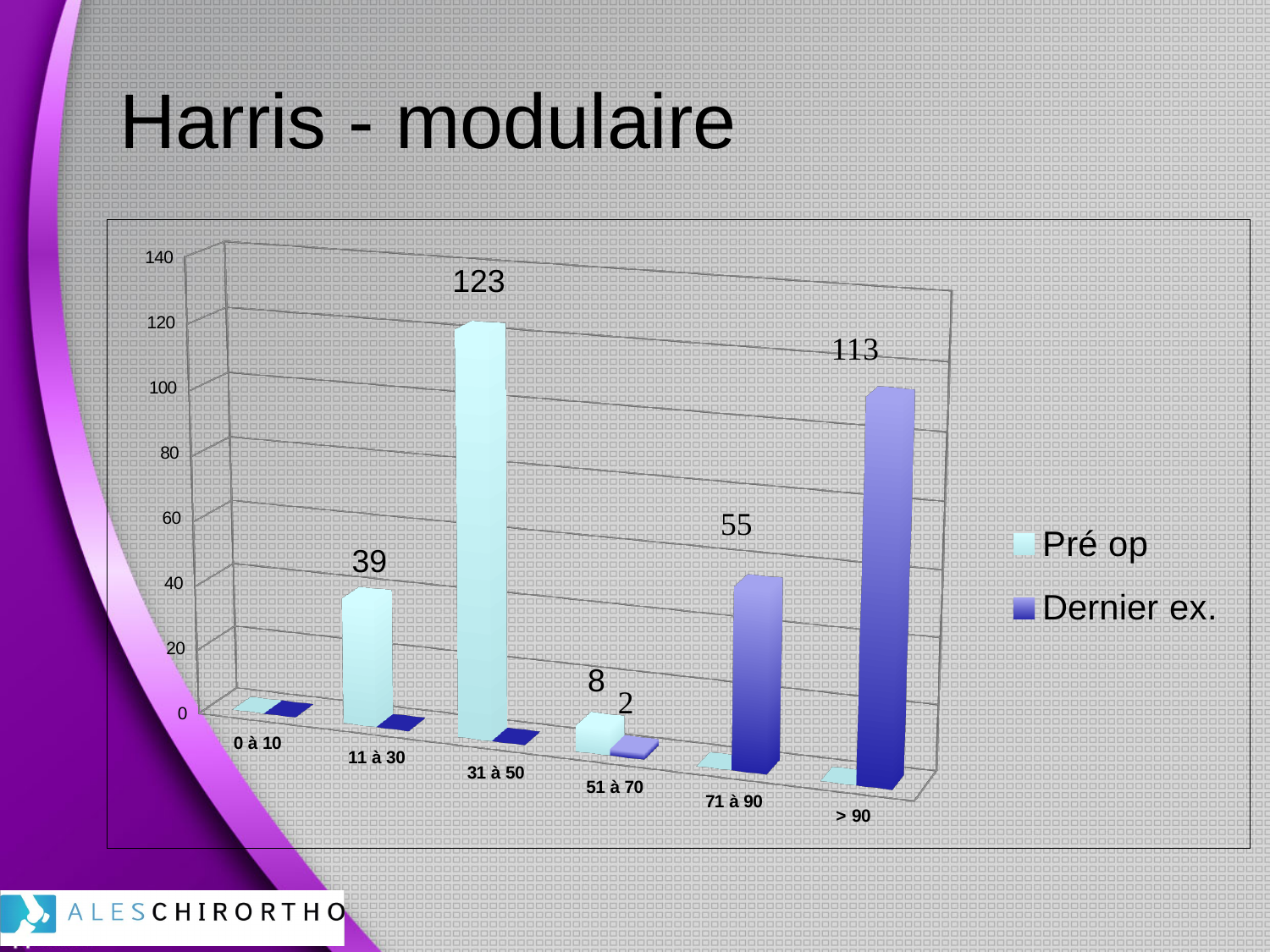
What is the Pré op value for the 31 à 50 category? 123 How many categories are shown on the x axis? 6 Which category has the highest Pré op value? 31 à 50 Which is larger: the Pré op value for 51 à 70 or the Dernier ex. value for 51 à 70? Pré op What is the Dernier ex. value for the 51 à 70 category? 2 What is the Dernier ex. value for the 71 à 90 category? 55 What is the Pré op value for the 11 à 30 category? 39 What is the Dernier ex. value for the > 90 category? 113 What kind of chart is shown on the slide? Bar chart How many series does the legend list? 2 What is the difference between the Pré op value for 31 à 50 and the Dernier ex. value for > 90? 10 Which category has the highest Dernier ex. value? > 90